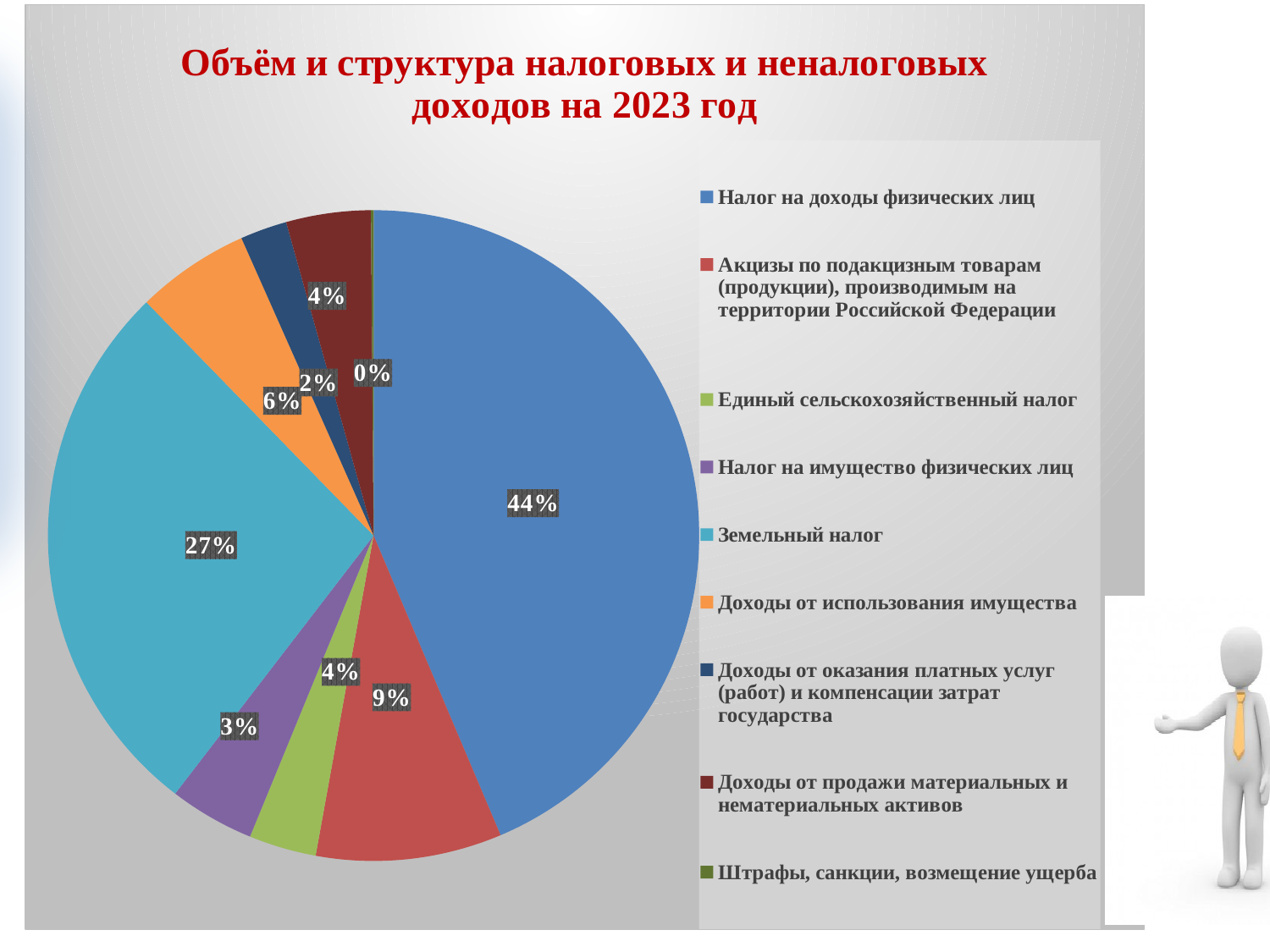
What is the difference between the shares of "Налог на доходы физических лиц" and "Земельный налог"? 17% Which is larger: the share of "Доходы от использования имущества" or the share of "Доходы от оказания платных услуг (работ) и компенсации затрат государства"? Доходы от использования имущества What share of the pie does "Налог на доходы физических лиц" have? 44% Which category has the smallest slice of the pie? Штрафы, санкции, возмещение ущерба What is the value shown for "Штрафы, санкции, возмещение ущерба"? 0% Which category has the largest slice of the pie? Налог на доходы физических лиц What share of the pie does "Земельный налог" have? 27% How many categories does the legend list? 9 What is the value shown for "Доходы от использования имущества"? 6% What kind of chart is shown on the slide? pie chart What is the value shown for "Акцизы по подакцизным товарам (продукции), производимым на территории Российской Федерации"? 9%